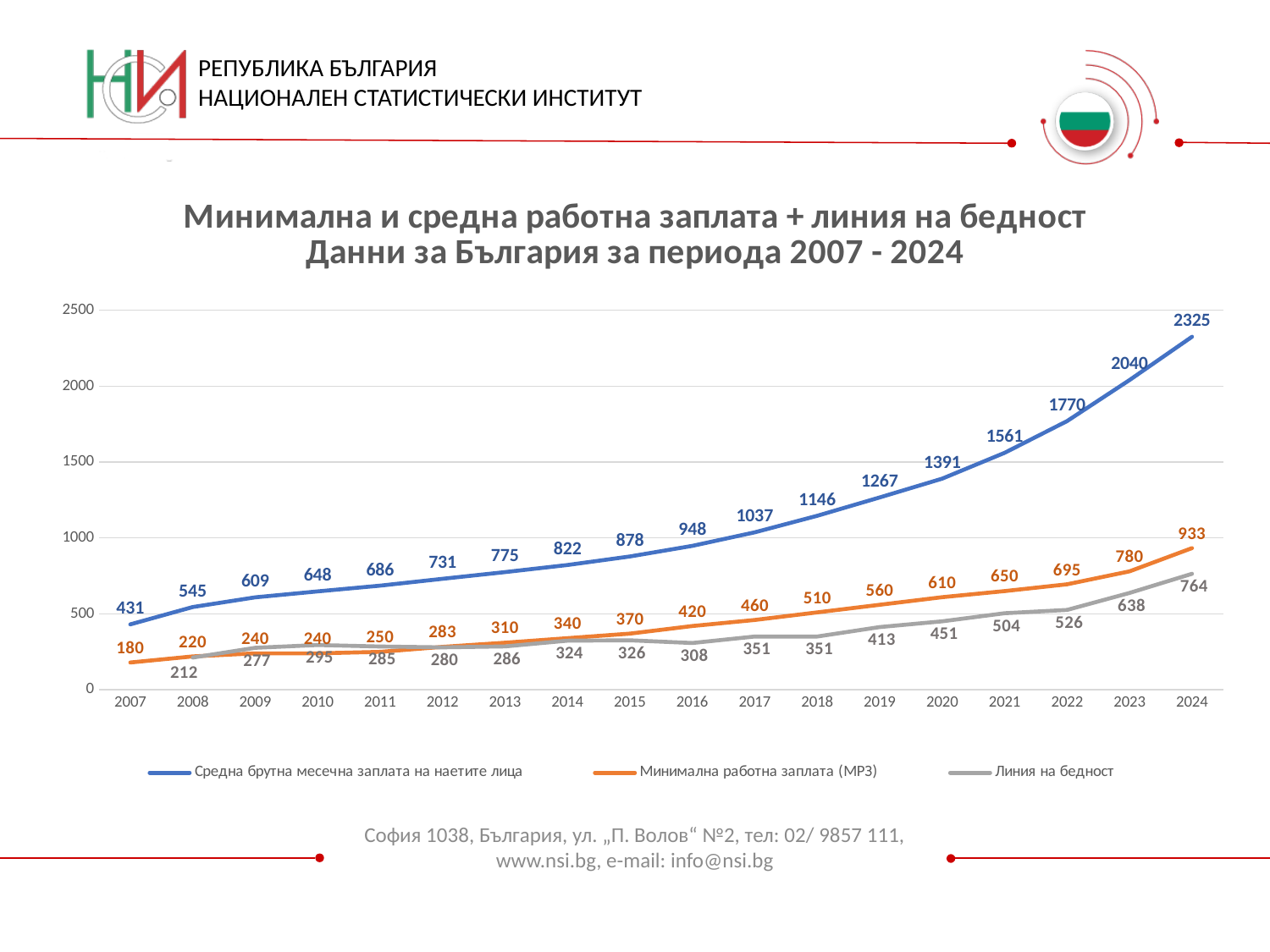
What is the minimum wage (Минимална работна заплата) value for 2016? 420 How many series does the legend list? 3 Which is larger in 2009: the minimum wage or the poverty line? poverty line (277) What type of chart is shown on the slide? line chart What colour is the line for the poverty line (Линия на бедност) series? gray What is the poverty line (Линия на бедност) value for 2021? 504 Does the average gross monthly wage series rise or fall from 2007 to 2024? rise What is the difference between the average gross monthly wage and the minimum wage in 2024? 1392 What is the value of the average gross monthly wage (Средна брутна месечна заплата на наетите лица) in 2024? 2325 In which year is the average gross monthly wage series at its lowest? 2007 In which year does the minimum wage series reach its highest value? 2024 How many years are shown on the x axis? 18